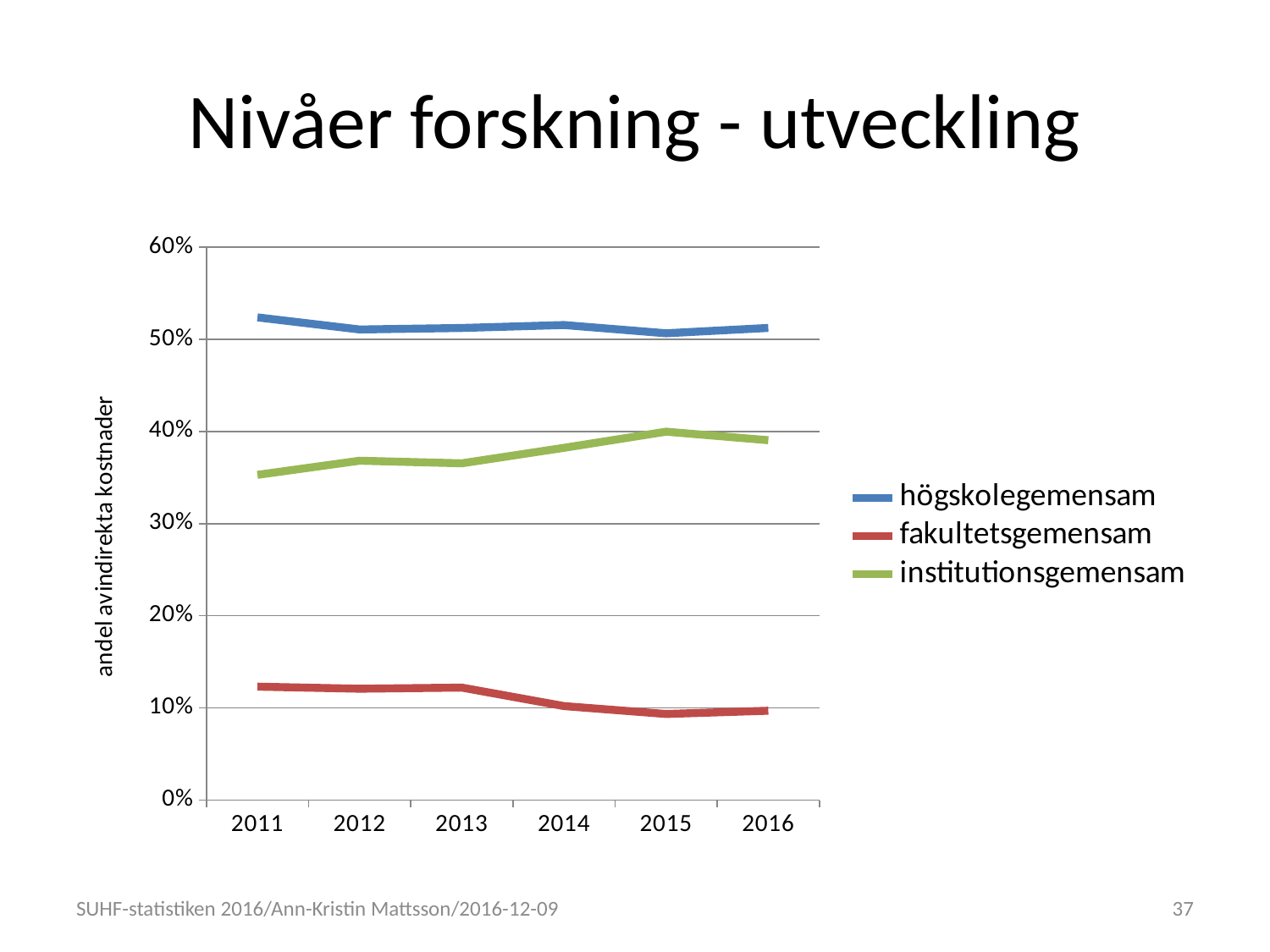
What kind of chart is shown on the slide? line chart Is the value for högskolegemensam in 2011 greater or less than 50%? greater How many series does the legend list? 3 Is the value for fakultetsgemensam in 2011 greater or less than 10%? greater Which series has the highest values across all years? högskolegemensam Is the value for fakultetsgemensam in 2015 greater or less than 10%? less Does the institutionsgemensam series generally rise or fall from 2011 to 2015? rise Which series has the lowest values across all years? fakultetsgemensam What is the title of the slide? Nivåer forskning - utveckling Which is larger in 2016: the value for institutionsgemensam or the value for fakultetsgemensam? institutionsgemensam How many years are shown on the x axis? 6